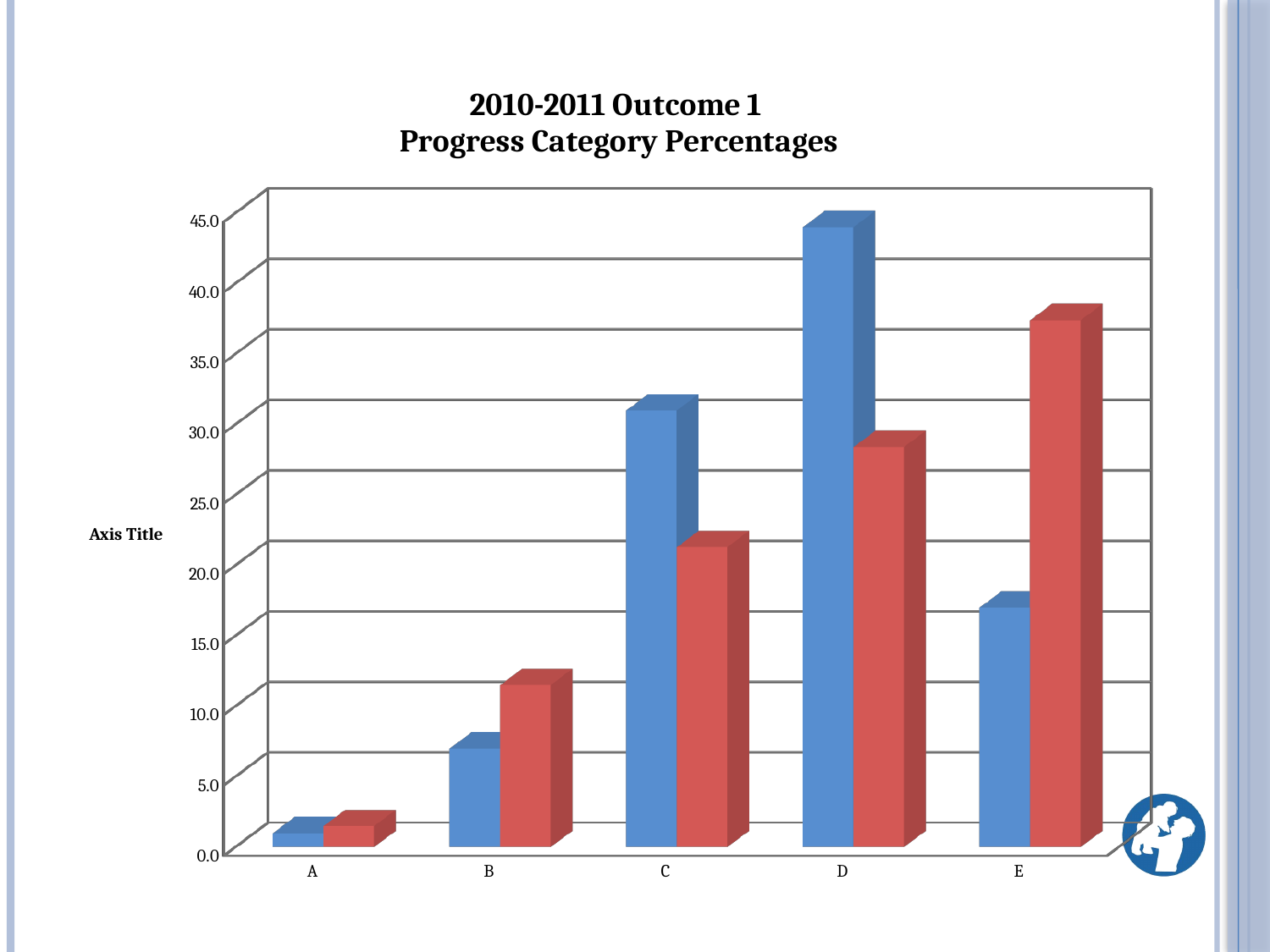
Which category has the tallest red bar? E Is the value of the red bar for C greater or less than 25.0? less For category C, which bar is taller, the blue one or the red one? Blue Which category has the shortest red bar? A For category E, which bar is taller, the blue one or the red one? Red What kind of chart is shown on the slide? Bar chart Which category has the tallest blue bar? D Which category has the shortest blue bar? A How many categories are shown on the x axis? 5 Is the value of the blue bar for D greater or less than 40.0? greater Is the value of the blue bar for E greater or less than 20.0? less What is the title of the chart? 2010-2011 Outcome 1 Progress Category Percentages